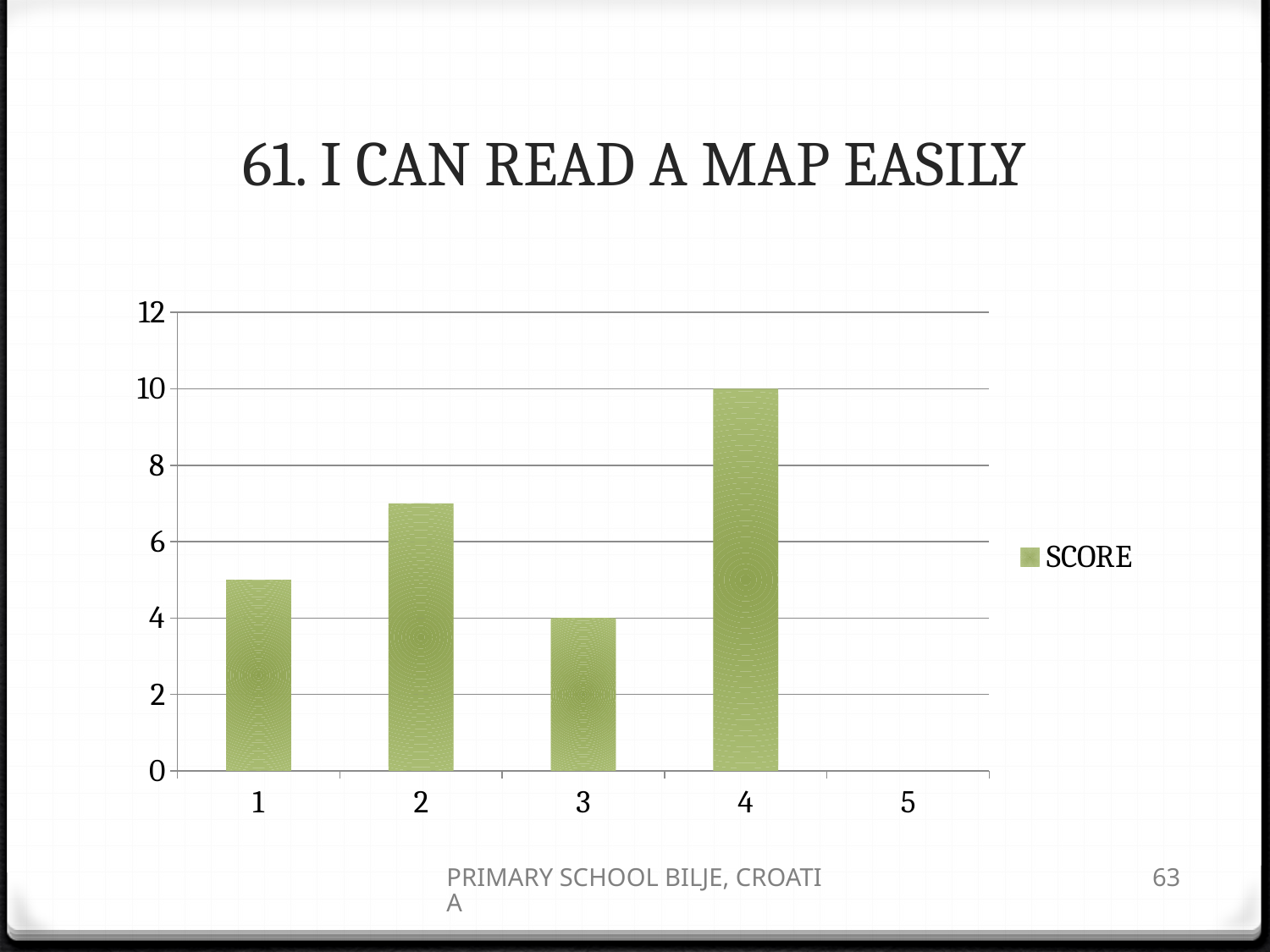
Is the value for category 2 greater or less than 8? less What is the value for category 4? 10 Which category has the highest value? 4 What is the value for category 5? 0 Is the value for category 1 greater or less than 4? greater What series name is listed in the legend? SCORE Which category has the lowest value? 5 What is the value for category 3? 4 Which is larger, the value for category 2 or the value for category 1? 2 What kind of chart is shown on the slide? bar chart How many categories are shown on the x axis? 5 What is the difference between the values for category 4 and category 3? 6